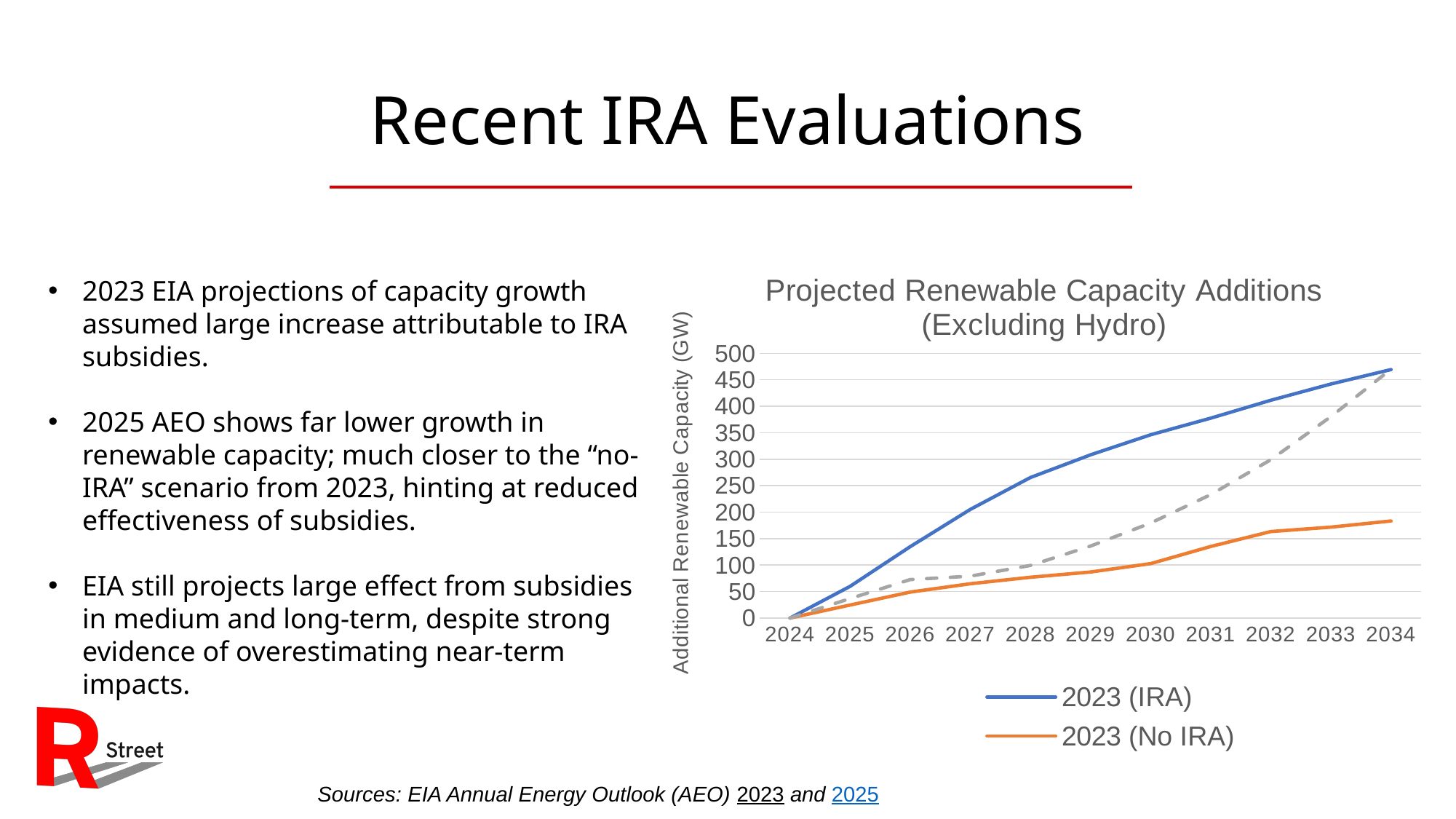
Do the values for 2023 (IRA) rise or fall from 2024 to 2034? rise What is the label on the vertical axis of the chart? Additional Renewable Capacity (GW) How many years are shown along the x axis of the chart? 11 How many series does the chart's legend list? 2 What is the title of the chart? Projected Renewable Capacity Additions (Excluding Hydro) In 2030, which series has the larger value, 2023 (IRA) or 2023 (No IRA)? 2023 (IRA) Is the value for 2023 (No IRA) in 2034 greater or less than 200? less In which year does the 2023 (IRA) series reach its highest value? 2034 Is the value for 2023 (No IRA) in 2029 greater or less than 100? less What kind of chart is shown on the slide? line chart Is the value for 2023 (IRA) in 2030 greater or less than 300? greater